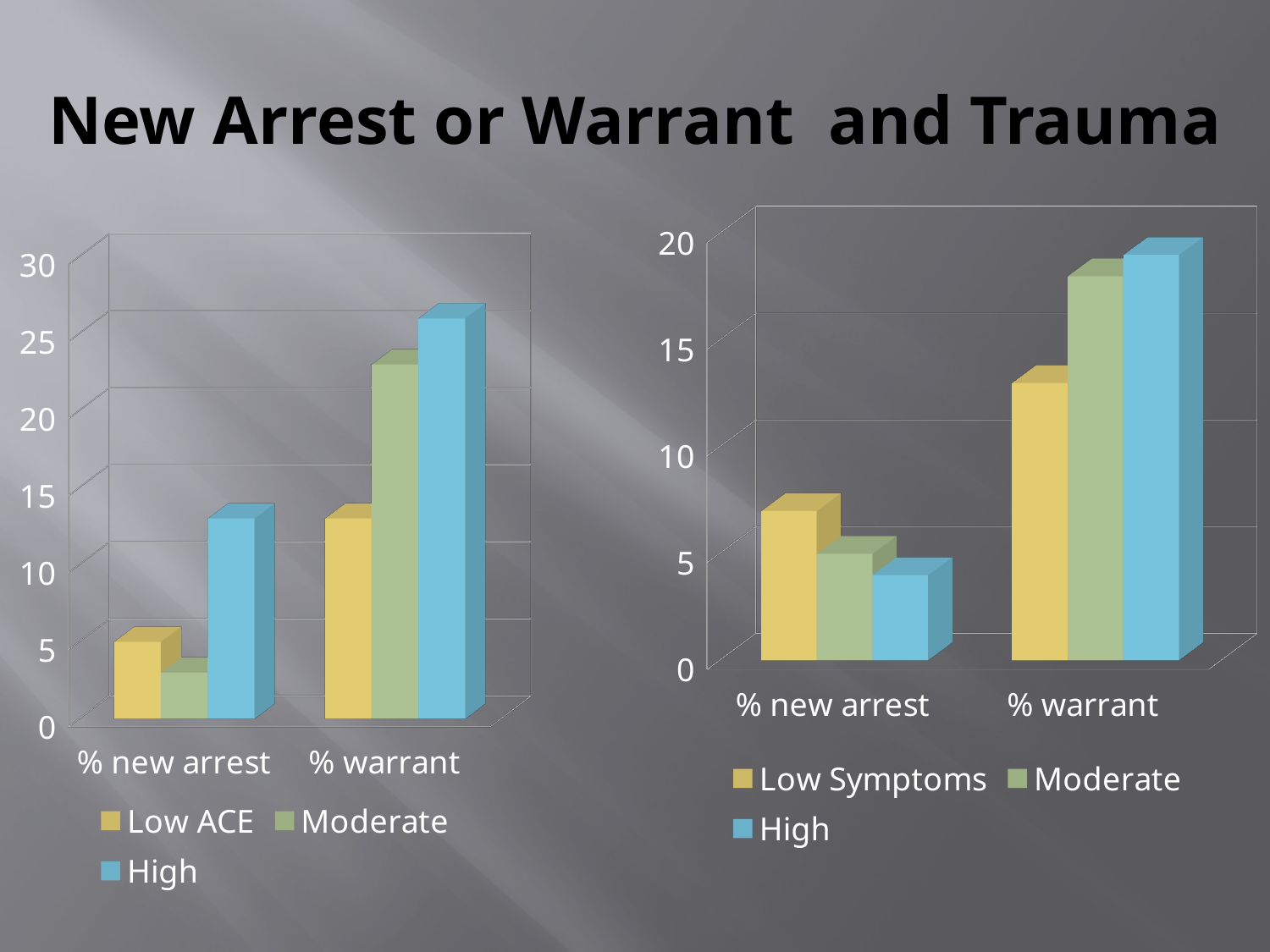
What are the three legend entries of the right chart? Low Symptoms, Moderate, High How many categories are shown on the x axis of the right chart? 2 In the left chart, which is larger for the Moderate series: % new arrest or % warrant? % warrant What is the title of the slide? New Arrest or Warrant and Trauma How many series does the legend of the left chart list? 3 In the right chart, do the values for the High series rise or fall from % new arrest to % warrant? rise What kind of chart is the left chart on the slide? bar chart In the left chart, which series has the highest value for % warrant? High In the left chart, is the value for High in % new arrest greater or less than 10? greater In the right chart, which series has the highest value for % new arrest? Low Symptoms In the right chart, is the value for High in % warrant greater or less than 15? greater In the left chart, which series has the lowest value for % new arrest? Moderate